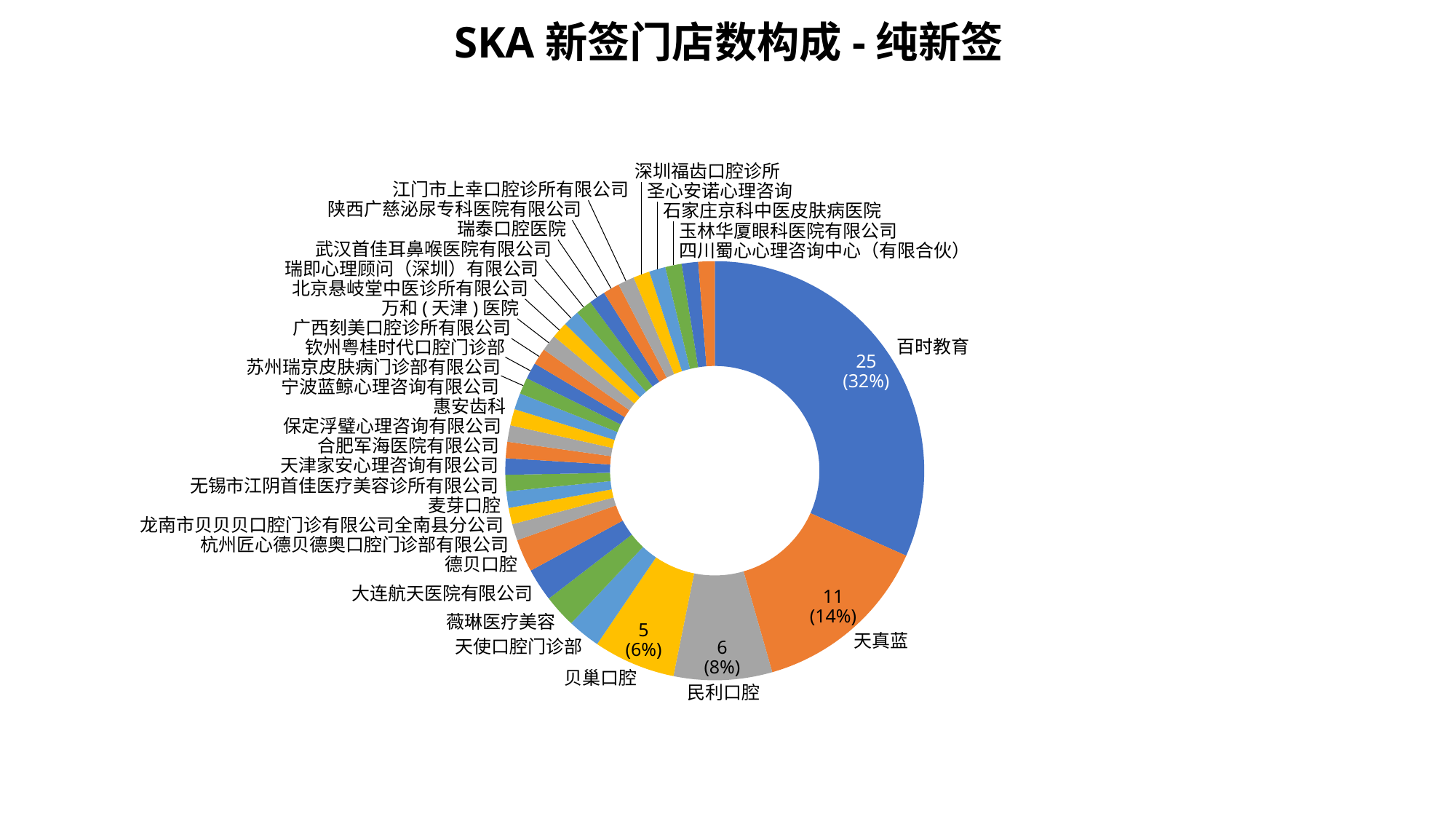
Which is larger, the value for 天真蓝 or the value for 民利口腔? 天真蓝 What is the value for 贝巢口腔? 5 What is the value for 天真蓝? 11 What kind of chart is shown on the slide? Pie chart (doughnut) What share of the total does 百时教育 represent? 32% What is the title of the chart? SKA 新签门店数构成 - 纯新签 What is the value for 民利口腔? 6 What is the difference between the values for 百时教育 and 天真蓝? 14 Which category has the largest slice of the chart? 百时教育 How many stores does 百时教育 account for? 25 What is the difference between the values for 民利口腔 and 贝巢口腔? 1 What share of the total does 民利口腔 represent? 8%